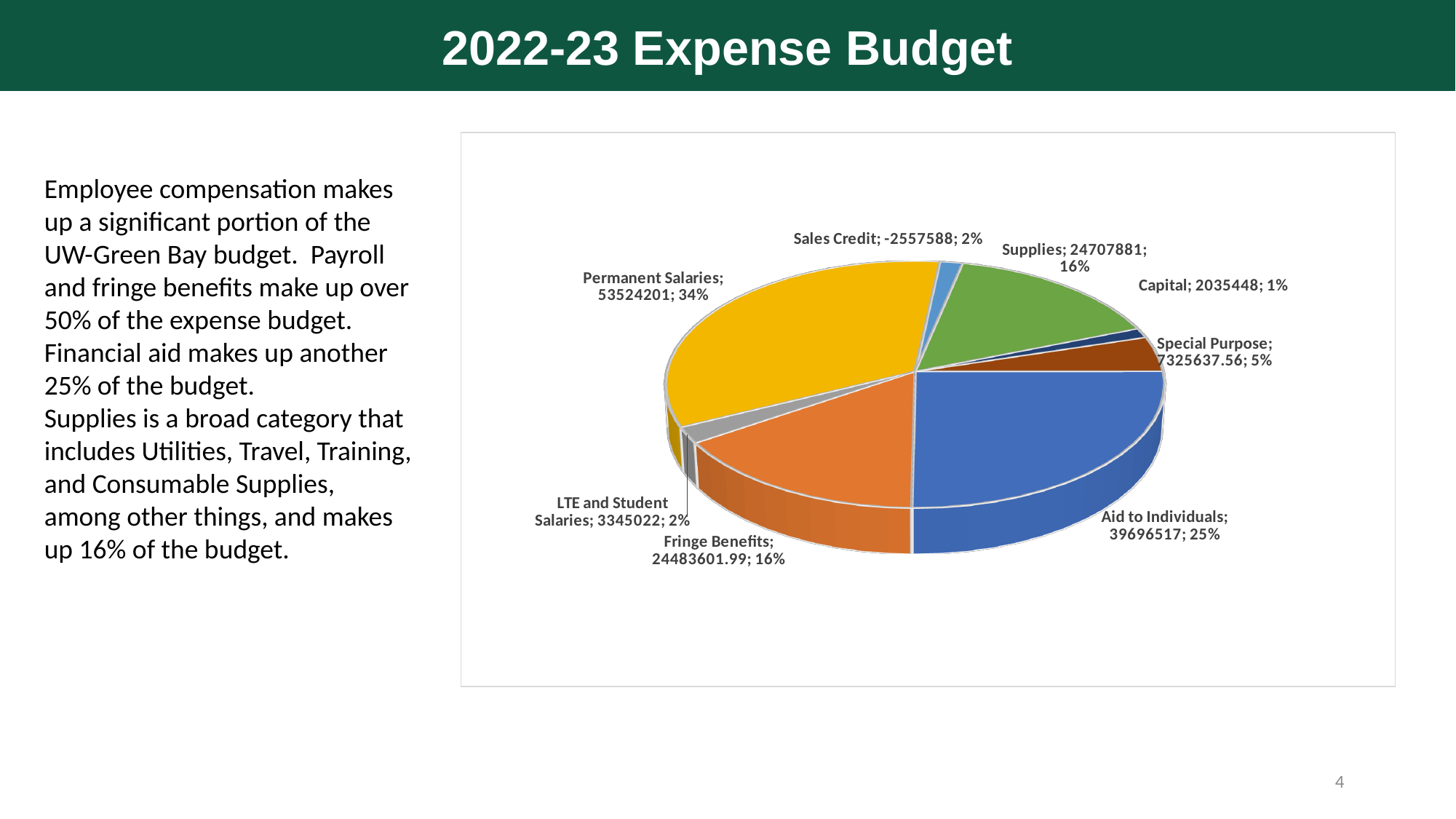
What share of the pie does Supplies represent? 16% What is the value for Special Purpose? 7325637.56 What is the value for Fringe Benefits? 24483601.99 What is the difference between the values for Permanent Salaries and Aid to Individuals? 13827684 Which category has the largest share of the pie? Permanent Salaries What kind of chart is shown on the slide? pie chart Which category has the smallest percentage share of the pie? Capital How many categories does the pie chart show? 8 What is the value for Permanent Salaries? 53524201 What is the value for Aid to Individuals? 39696517 Which is larger, the value for Aid to Individuals or the value for Supplies? Aid to Individuals What is the title of the slide containing the chart? 2022-23 Expense Budget